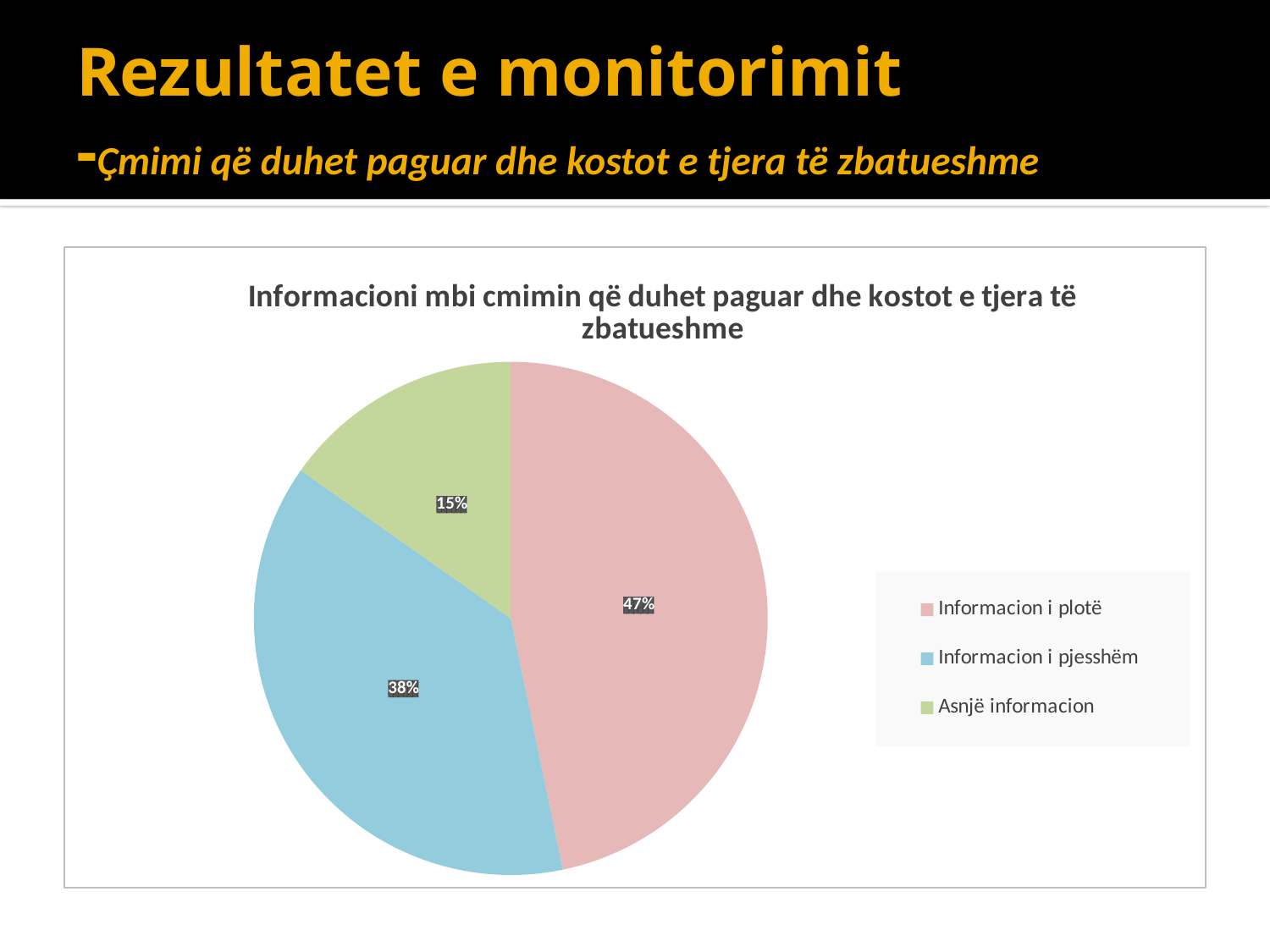
What share of the pie is labelled 'Asnjë informacion'? 15% Which category has the largest slice of the pie? Informacion i plotë What type of chart is shown on the slide? pie chart What is the title of the chart? Informacioni mbi cmimin që duhet paguar dhe kostot e tjera të zbatueshme What colour is the slice for 'Asnjë informacion'? green How many slices does the pie chart have? 3 Which category has the smallest slice of the pie? Asnjë informacion What share of the pie is labelled 'Informacion i plotë'? 47% What is the difference in percentage points between 'Informacion i plotë' and 'Informacion i pjesshëm'? 9 How many entries does the legend list? 3 What share of the pie is labelled 'Informacion i pjesshëm'? 38% Which is larger, the slice for 'Informacion i pjesshëm' or the slice for 'Asnjë informacion'? Informacion i pjesshëm